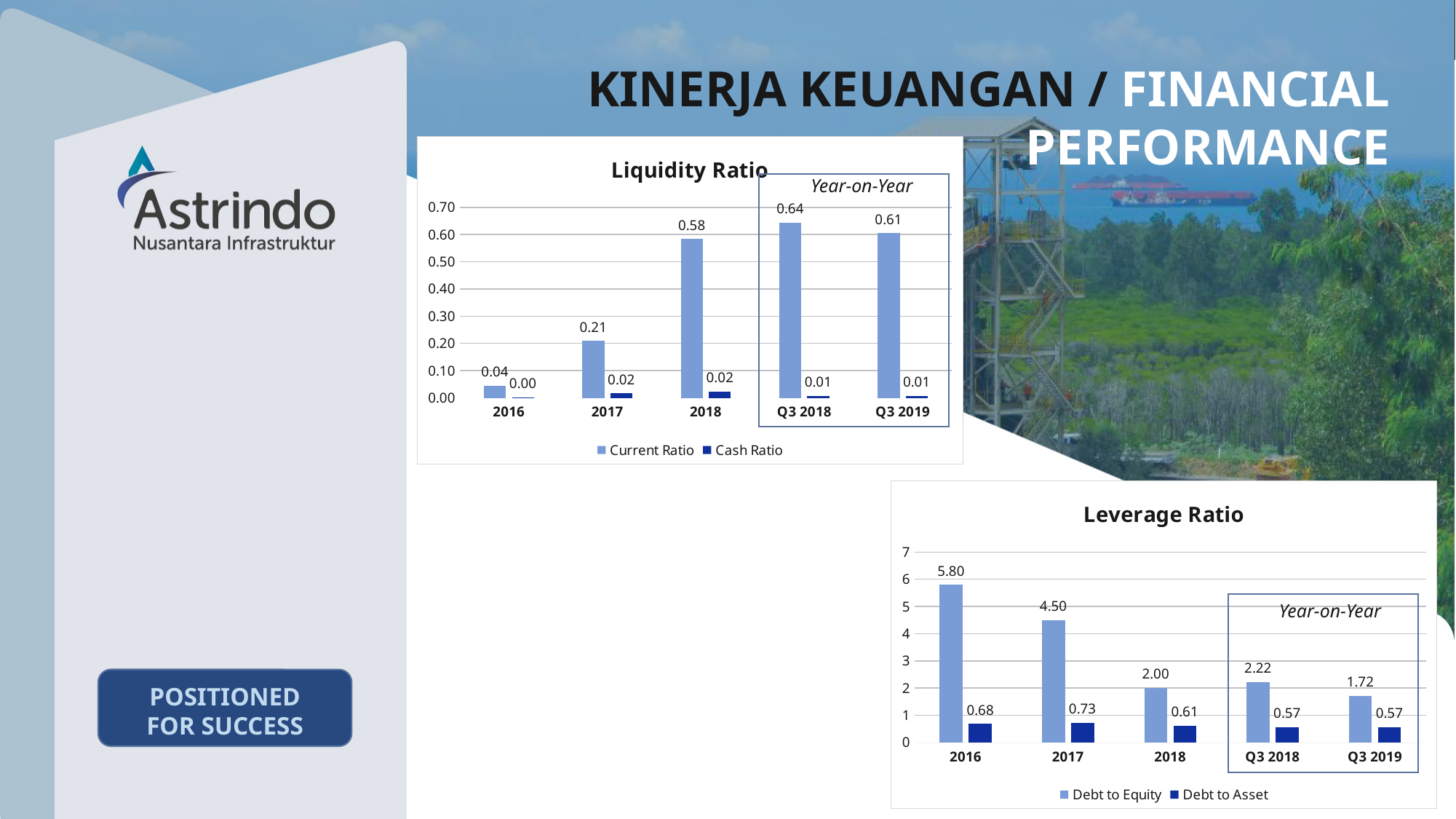
In the Leverage Ratio chart, what is the Debt to Equity value for 2017? 4.50 In the Liquidity Ratio chart, what is the Cash Ratio for Q3 2019? 0.01 In the Leverage Ratio chart, does the Debt to Equity value rise or fall from 2016 to 2018? fall In the Liquidity Ratio chart, is the Current Ratio for 2017 greater or less than 0.30? less In the Leverage Ratio chart, what is the difference between the Debt to Equity values for Q3 2018 and Q3 2019? 0.50 What kind of chart is the Leverage Ratio chart? bar chart In the Leverage Ratio chart, what is the Debt to Asset value for 2016? 0.68 In the Liquidity Ratio chart, what is the difference between the Current Ratio for 2018 and 2017? 0.37 In the Liquidity Ratio chart, how many series does the legend list? 2 In the Liquidity Ratio chart, what is the Current Ratio for 2018? 0.58 In the Leverage Ratio chart, which category has the lowest Debt to Equity value? Q3 2019 In the Liquidity Ratio chart, which category has the highest Current Ratio? Q3 2018